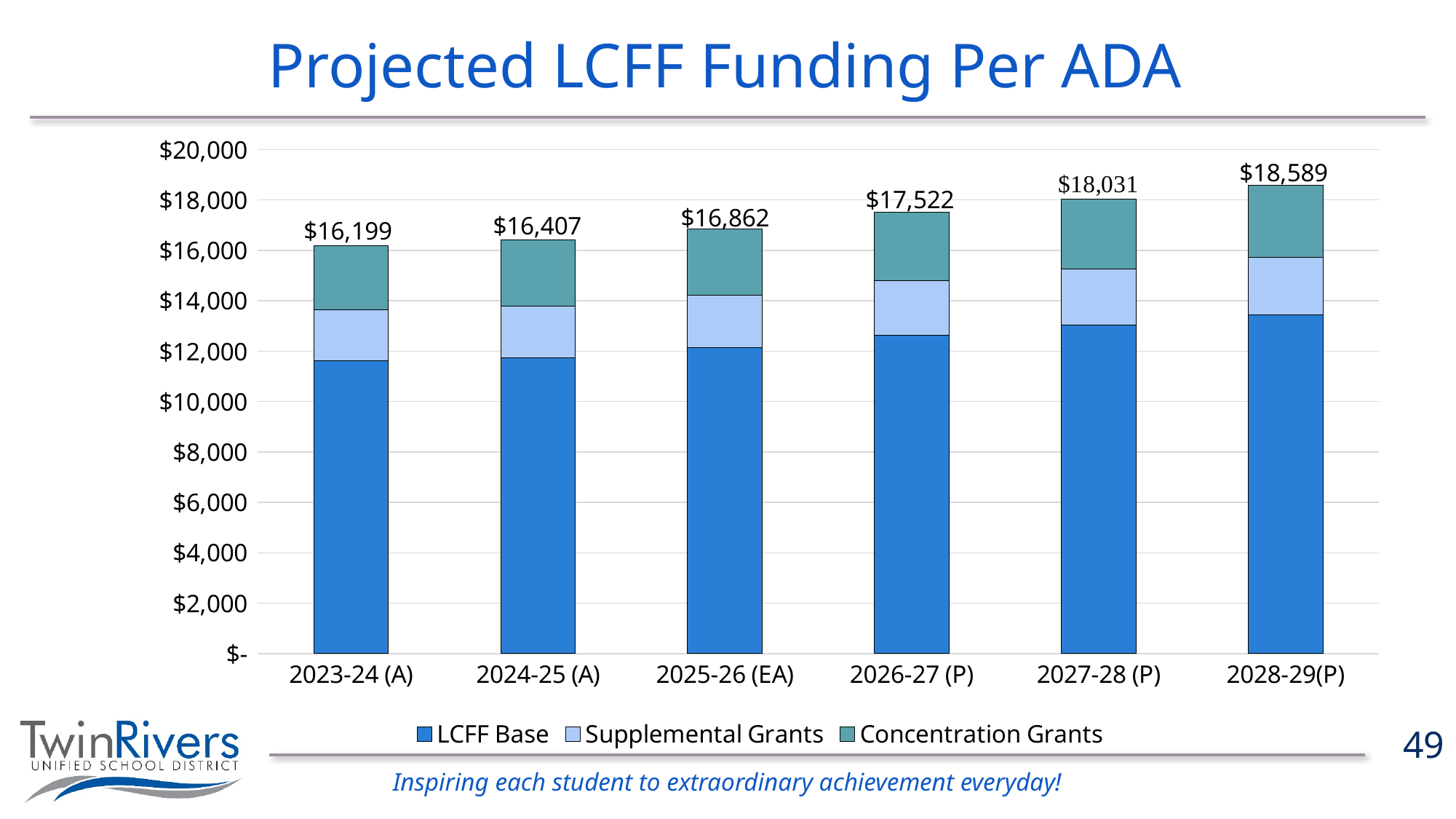
What is the total projected LCFF funding per ADA for 2026-27 (P)? $17,522 How many years are shown on the x axis of the chart? 6 Do the total values rise or fall from 2023-24 (A) to 2028-29(P)? rise What is the total projected LCFF funding per ADA for 2028-29(P)? $18,589 How many series does the legend list? 3 What is the difference between the total for 2028-29(P) and the total for 2023-24 (A)? $2,390 Which year has the highest total projected LCFF funding per ADA? 2028-29(P) What is the difference between the total for 2026-27 (P) and the total for 2025-26 (EA)? $660 What is the total projected LCFF funding per ADA for 2023-24 (A)? $16,199 Which is larger, the total for 2024-25 (A) or the total for 2027-28 (P)? 2027-28 (P) Which year has the lowest total projected LCFF funding per ADA? 2023-24 (A) Is the LCFF Base value for 2023-24 (A) greater or less than $12,000? less